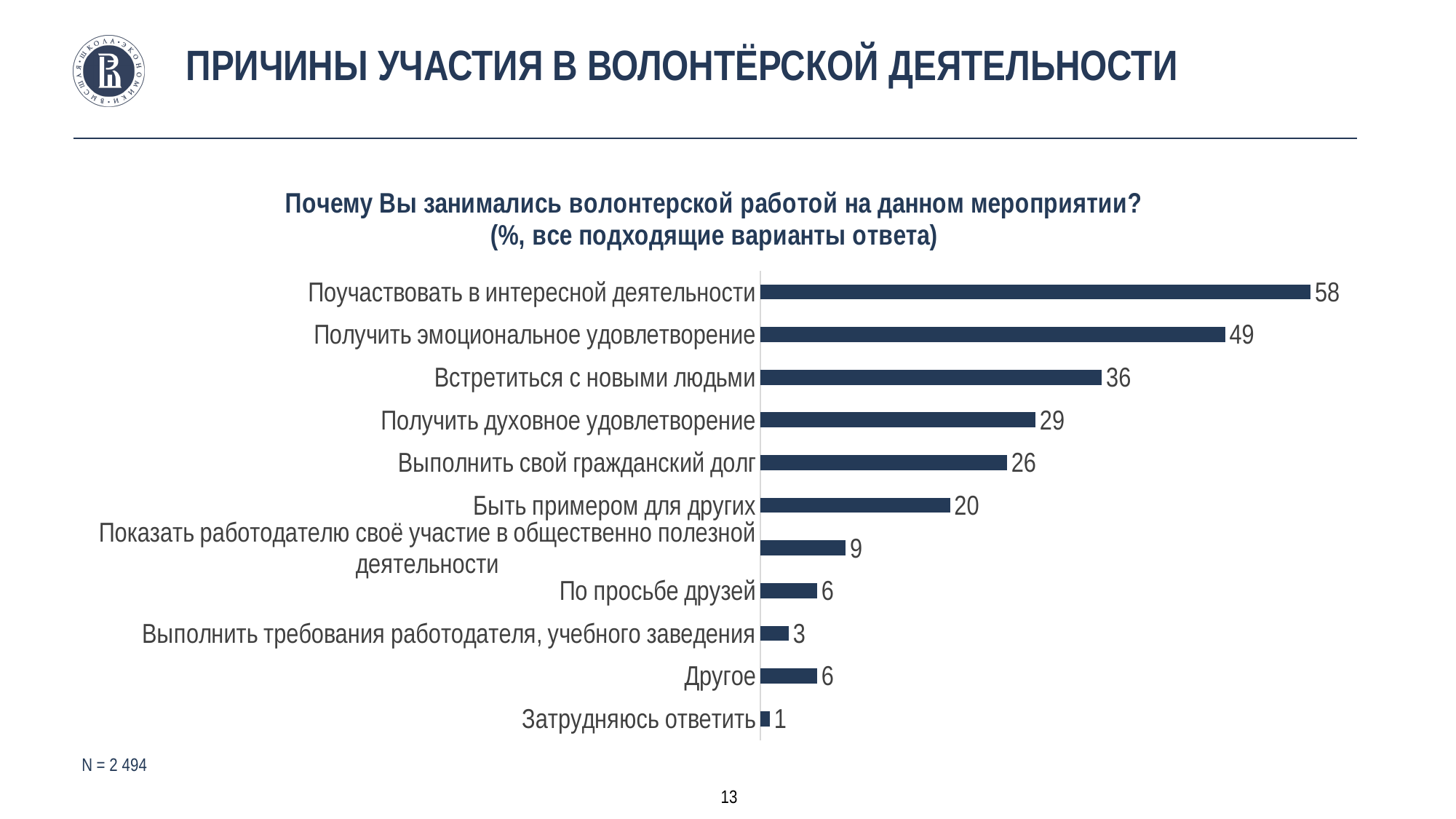
What is the difference between the values for "Поучаствовать в интересной деятельности" and "Получить эмоциональное удовлетворение"? 9 How many categories are shown in the chart? 11 What is the difference between the values for "Получить духовное удовлетворение" and "Выполнить свой гражданский долг"? 3 Which is larger: the value for "Быть примером для других" or the value for "Показать работодателю своё участие в общественно полезной деятельности"? Быть примером для других What is the value for "Поучаствовать в интересной деятельности"? 58 What is the value for "Встретиться с новыми людьми"? 36 Which category has the highest value? Поучаствовать в интересной деятельности What is the value for "Другое"? 6 Which category has the lowest value? Затрудняюсь ответить What is the value for "Выполнить требования работодателя, учебного заведения"? 3 What kind of chart is shown on the slide? Bar chart What is the sample size (N) stated on the slide? N = 2 494